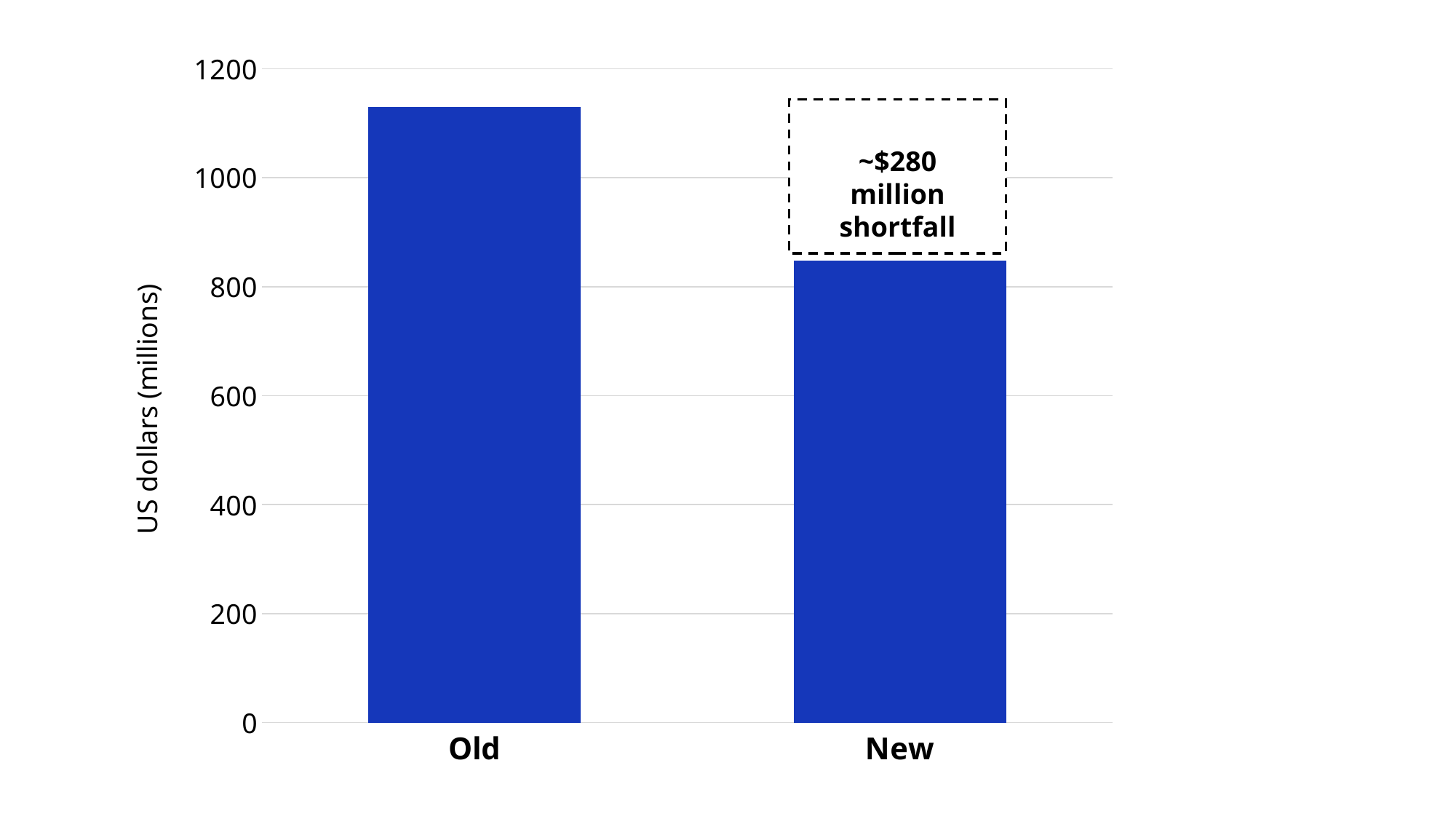
What kind of chart is shown on the slide? bar chart Which is larger, the value for Old or the value for New? Old What is the label on the y axis? US dollars (millions) What does the dashed box above the New bar say? ~$280 million shortfall How many categories are plotted on the x axis? 2 Which category has the highest value? Old Which category has the lowest value? New Is the value for Old greater or less than 1000? greater Is the value for Old greater or less than 1200? less Is the value for New greater or less than 800? greater Do the values rise or fall from Old to New? fall